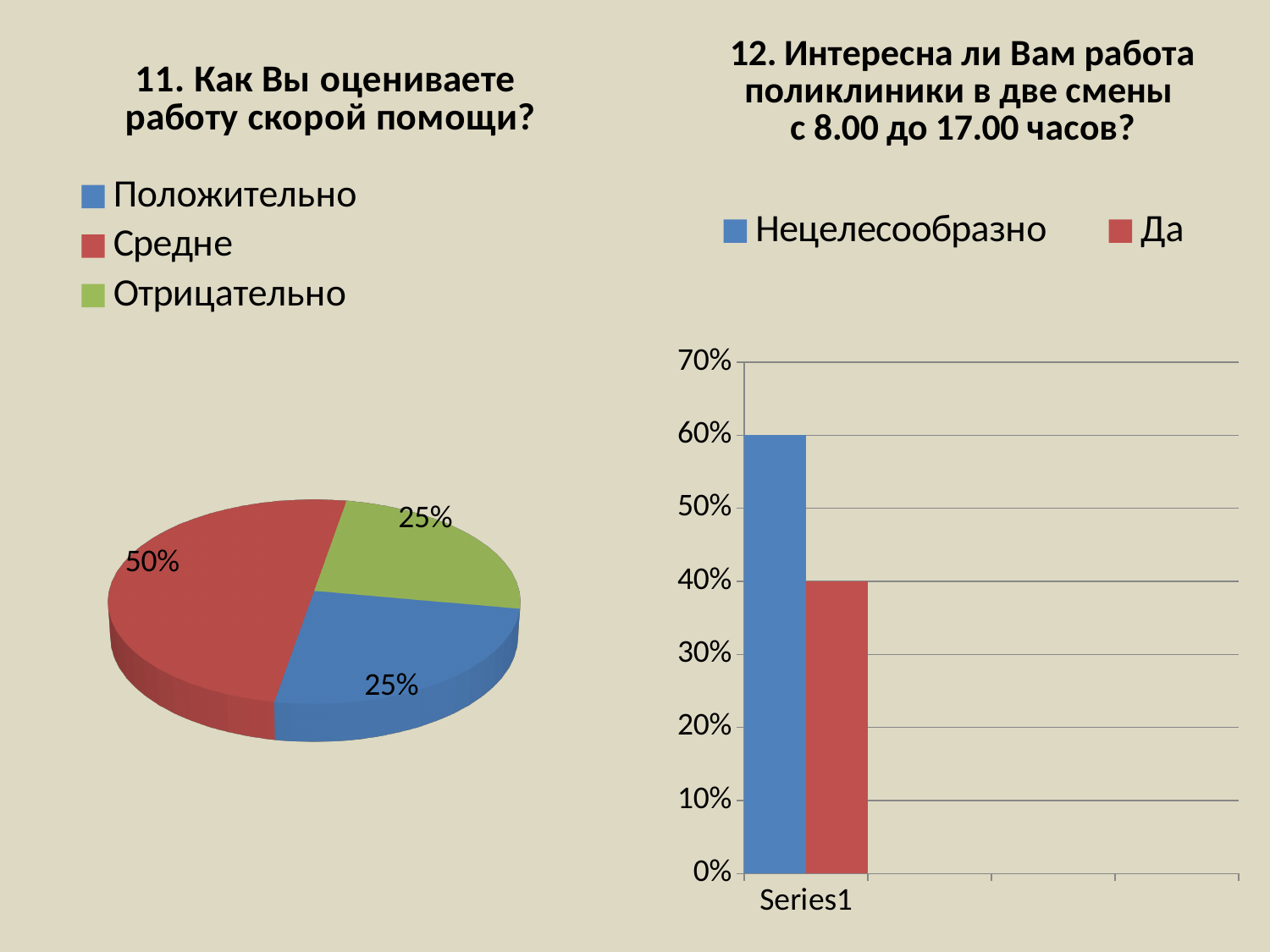
In the bar chart on the right, what is the value for Да? 40% What kind of chart is shown on the right side of the slide? Bar chart What kind of chart is shown on the left side of the slide? Pie chart In the pie chart on the left, which category has the largest slice? Средне In the pie chart on the left, what is the difference between the shares for Средне and Отрицательно? 25% In the bar chart on the right, which series has the higher value, Нецелесообразно or Да? Нецелесообразно In the pie chart titled "11. Как Вы оцениваете работу скорой помощи?", what share is labelled for Средне? 50% In the pie chart on the left, how many categories does the legend list? 3 In the pie chart on the left, what share is labelled for Положительно? 25% In the bar chart on the right, how many series does the legend list? 2 In the chart titled "12. Интересна ли Вам работа поликлиники в две смены с 8.00 до 17.00 часов?", what is the value for Нецелесообразно? 60% In the bar chart on the right, what is the difference between the values for Нецелесообразно and Да? 20%